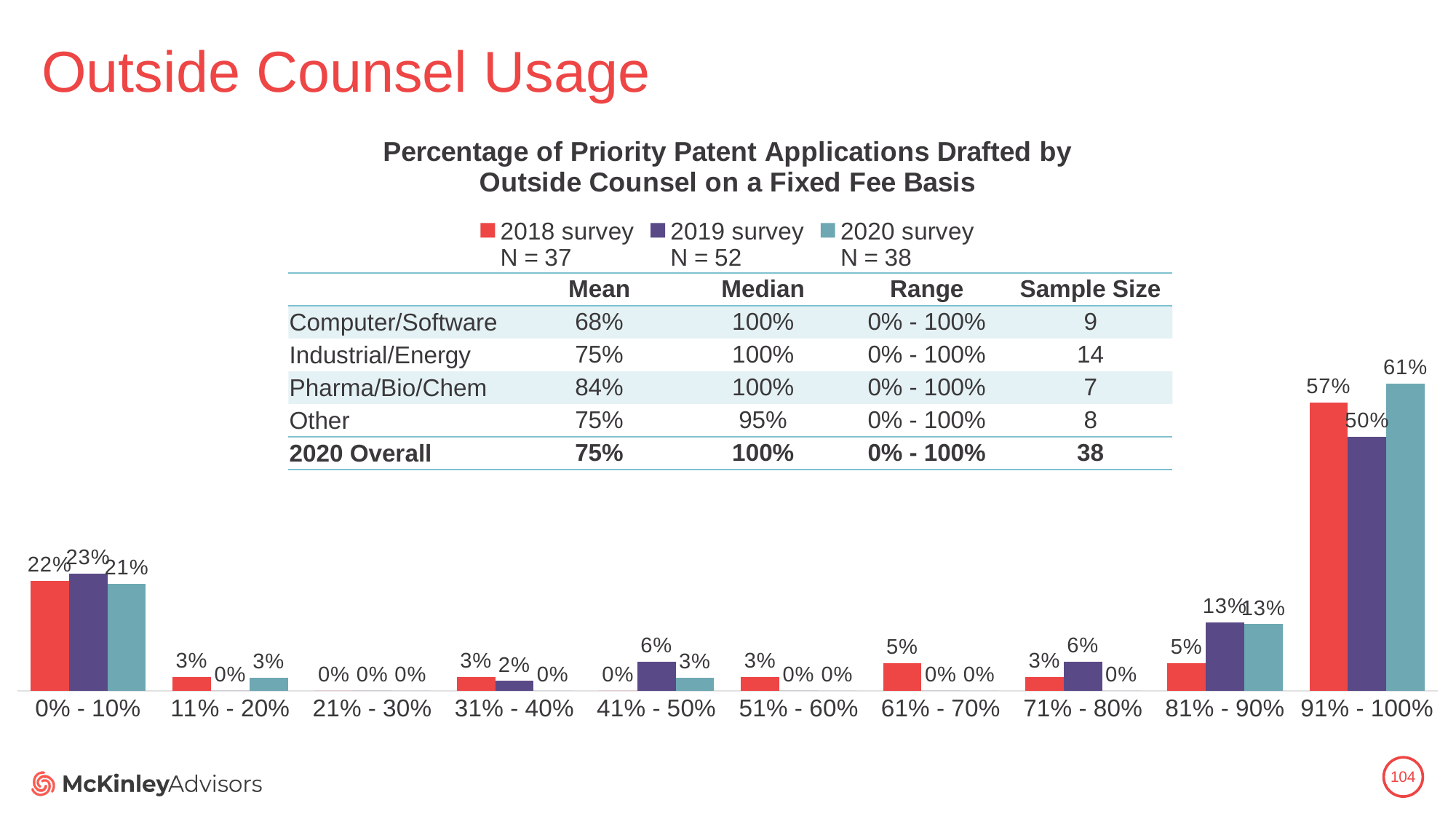
How many categories are shown on the x axis of the chart? 10 How many series does the chart legend list? 3 What is the difference between the 2018 survey and 2019 survey values in the 81% - 90% category? 8% What kind of chart is shown on the slide? Bar chart What is the sample size (N) for the 2019 survey shown in the legend? 52 Which category has the highest value for the 2019 survey? 91% - 100% In the 91% - 100% category, which is larger: the 2018 survey value or the 2019 survey value? 2018 survey What is the 2018 survey value for the 0% - 10% category? 22% What is the 2019 survey value for the 81% - 90% category? 13% What is the 2019 survey value for the 41% - 50% category? 6% What is the difference between the 2020 survey and 2019 survey values in the 91% - 100% category? 11% What is the 2020 survey value for the 91% - 100% category? 61%